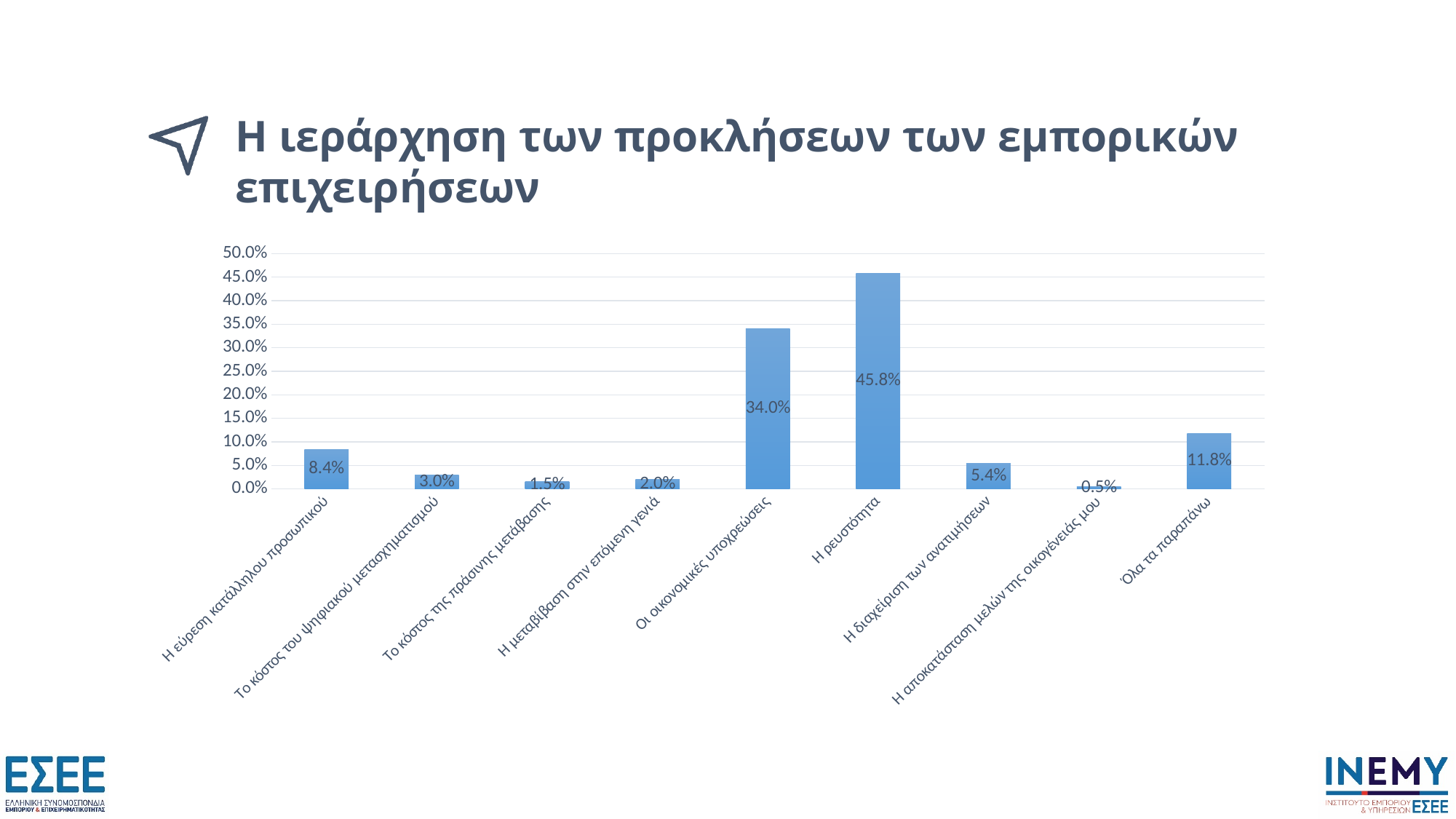
Which category has the highest value? Η ρευστότητα Is the value for Οι οικονομικές υποχρεώσεις greater or less than 30.0%? greater What is the value for Οι οικονομικές υποχρεώσεις? 34.0% What kind of chart is shown on the slide? bar chart What is the difference between the values for Η ρευστότητα and Οι οικονομικές υποχρεώσεις? 11.8% How many categories are shown on the x axis? 9 What is the value for Όλα τα παραπάνω? 11.8% What is the value for Η εύρεση κατάλληλου προσωπικού? 8.4% What is the title of the slide? Η ιεράρχηση των προκλήσεων των εμπορικών επιχειρήσεων What is the value for Η ρευστότητα? 45.8% Which category has the lowest value? Η αποκατάσταση μελών της οικογένειάς μου